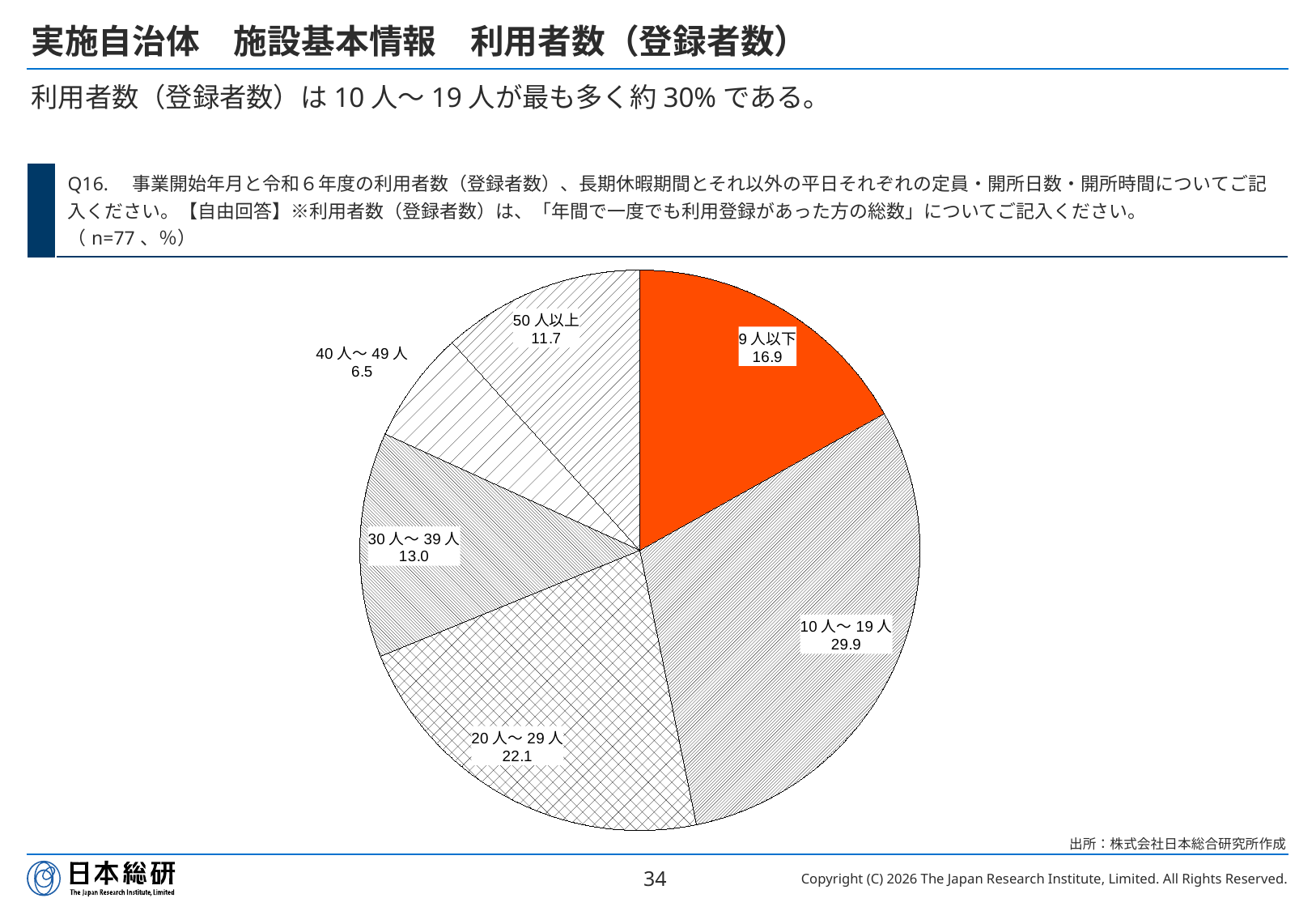
What is the value shown for the 50人以上 slice? 11.7 Which category has the largest share of the pie? 10人〜19人 Which category has the smallest share of the pie? 40人〜49人 How many slices does the pie chart have? 6 What type of chart is shown on the slide? pie chart What share of the pie does the 20人〜29人 slice represent? 22.1 What is the value shown for the 9人以下 slice? 16.9 What is the difference between the values for 10人〜19人 and 20人〜29人? 7.8 Which is larger, the value for 30人〜39人 or the value for 50人以上? 30人〜39人 Which slice of the pie is filled in solid orange? 9人以下 What is the value shown for the 40人〜49人 slice? 6.5 What is the value shown for the 10人〜19人 slice? 29.9